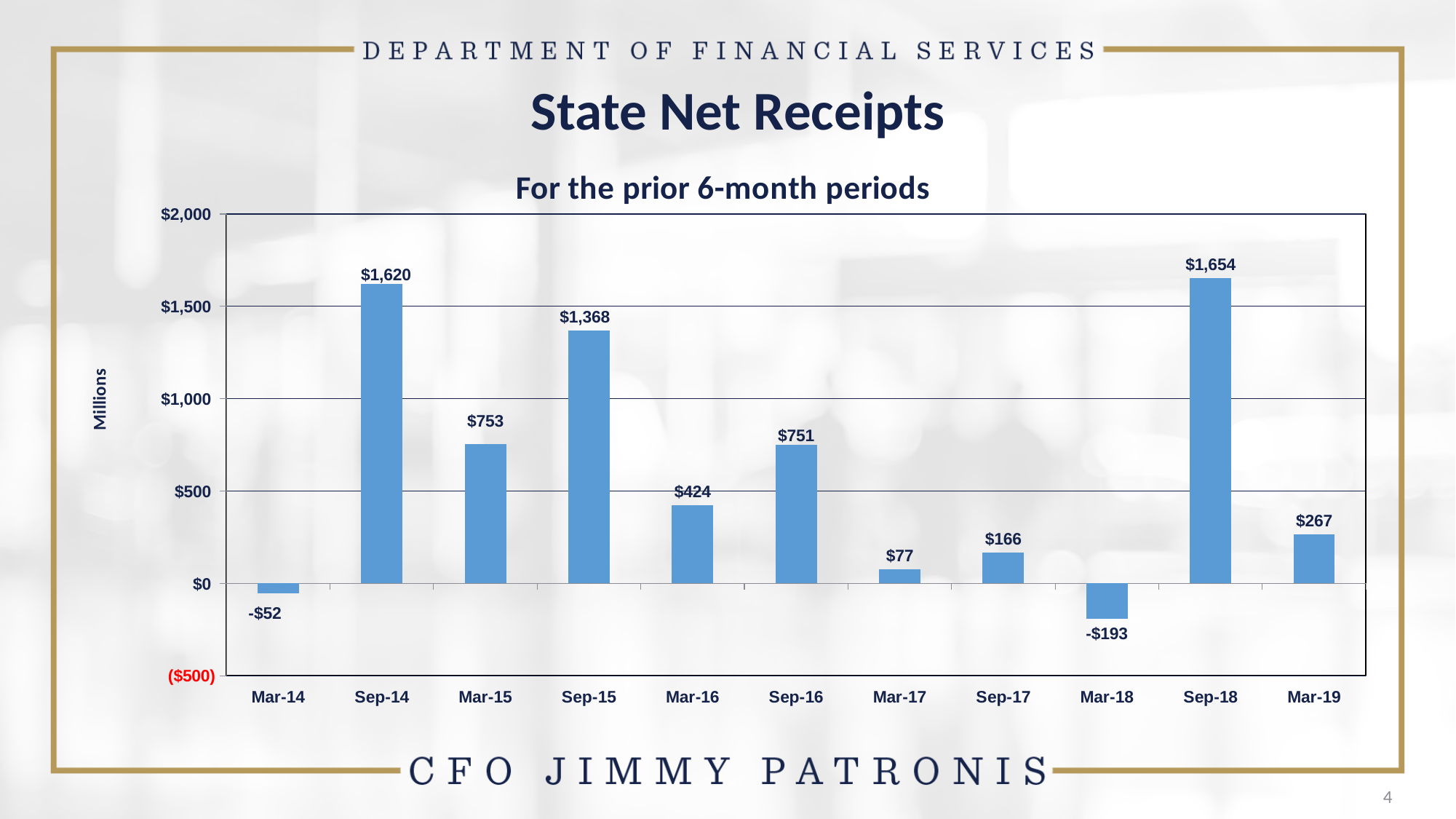
What is the value for Mar-18? -$193 What is the difference between the values for Mar-15 and Sep-16? $2 What kind of chart is shown? bar chart Which period has the highest value? Sep-18 How many periods are shown on the x axis? 11 What is the difference between the values for Sep-18 and Sep-14? $34 Which period has the lowest value? Mar-18 What is the value for Sep-14? $1,620 Is the value for Mar-16 greater or less than $500? less What is the value for Mar-19? $267 Which is larger, the value for Sep-15 or the value for Sep-16? Sep-15 What unit is shown on the y axis label? Millions